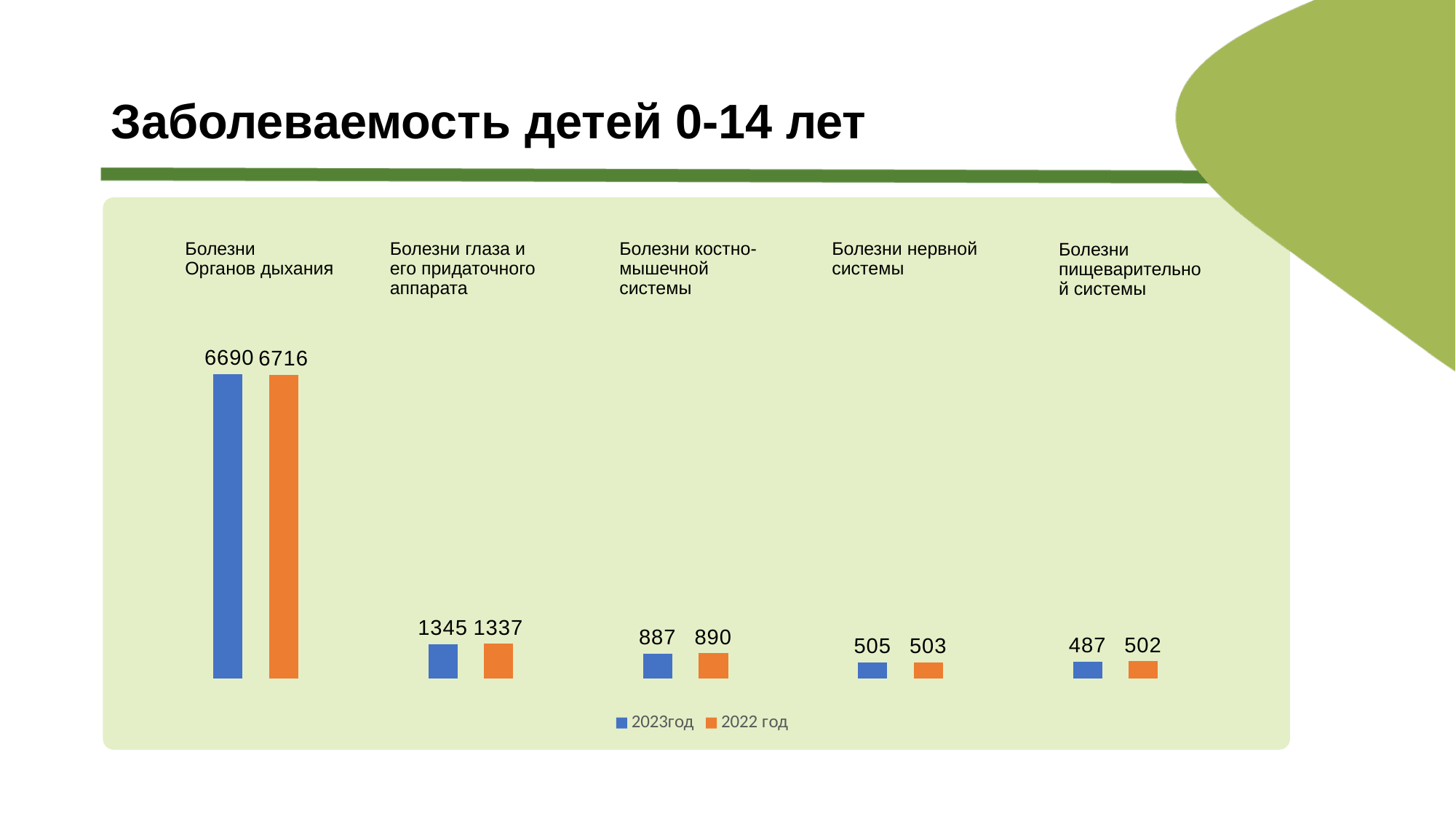
What kind of chart is shown on the slide? Bar chart Which colour represents 2022 год in the chart? Orange What is the difference between the 2023год and 2022 год values for Болезни глаза и его придаточного аппарата? 8 What is the value for Болезни органов дыхания in 2023год? 6690 What is the difference between the 2022 год and 2023год values for Болезни органов дыхания? 26 What is the value for Болезни нервной системы in 2022 год? 503 Which category has the lowest value in 2023год? Болезни пищеварительной системы Which is larger for Болезни пищеварительной системы: the 2023год value or the 2022 год value? 2022 год Which category has the highest value in 2023год? Болезни органов дыхания How many disease categories are shown in the chart? 5 How many series does the legend list? 2 What is the value for Болезни глаза и его придаточного аппарата in 2023год? 1345